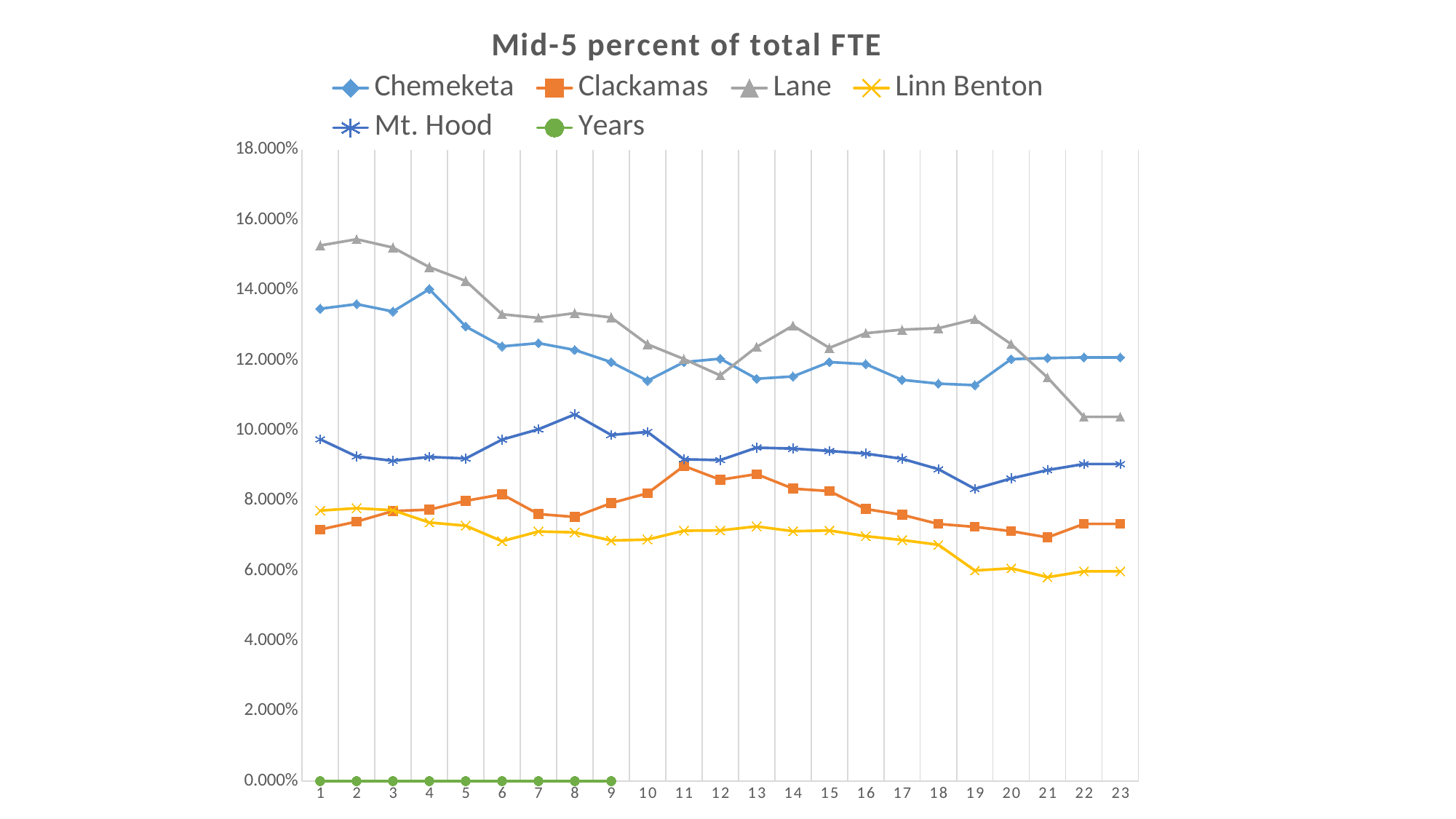
Does the Lane series rise or fall overall from point 1 to point 23? fall Is the value for Linn Benton at point 19 greater or less than 8.000%? less At point 23, which is higher, Chemeketa or Lane? Chemeketa What is the title of the chart? Mid-5 percent of total FTE Is the value for Lane at point 1 greater or less than 14.000%? greater Which series has the lowest value at point 23? Linn Benton Which series has the highest value at point 1? Lane How many series does the legend list? 6 What kind of chart is shown on the slide? line chart Is the value for Lane at point 23 greater or less than 12.000%? less How many points are on the x axis of the chart? 23 At point 19, which is higher, Clackamas or Linn Benton? Clackamas